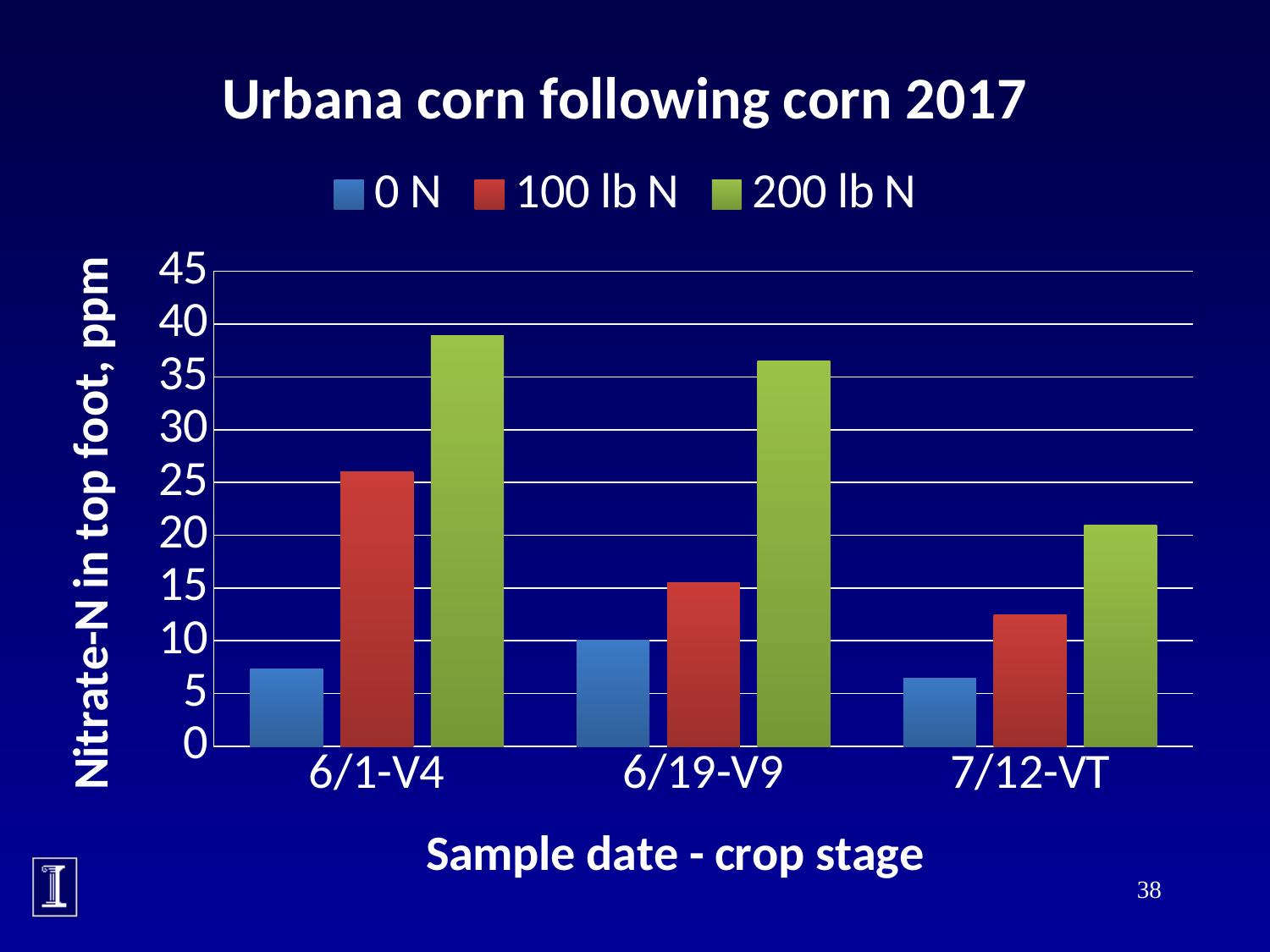
Do the values for the 100 lb N series rise or fall across the sample dates from 6/1-V4 to 7/12-VT? fall How many sample date categories are shown on the x axis? 3 What is the title of the chart? Urbana corn following corn 2017 How many series does the legend list? 3 What is the label of the y axis? Nitrate-N in top foot, ppm What kind of chart is shown on the slide? bar chart Which sample date has the lowest value for the 100 lb N series? 7/12-VT Is the value for 100 lb N at 6/19-V9 greater or less than 20? less Which sample date has the highest value for the 200 lb N series? 6/1-V4 Is the value for 200 lb N at 6/1-V4 greater or less than 35? greater Which sample date has the highest value for the 0 N series? 6/19-V9 Which is larger at 7/12-VT, the 100 lb N value or the 200 lb N value? 200 lb N